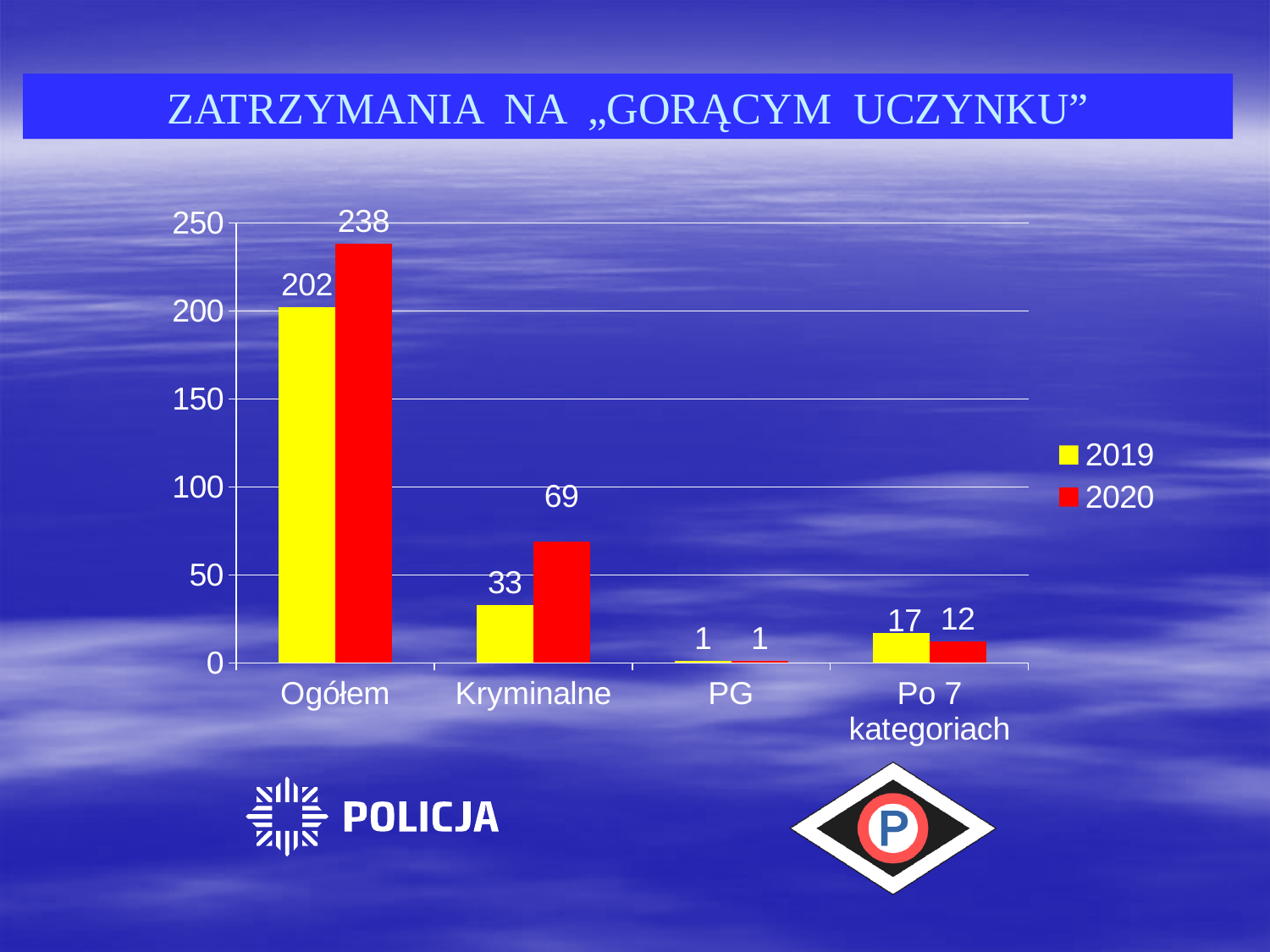
Which category has the highest value in 2020? Ogółem What is the value for Po 7 kategoriach in 2020? 12 Which is larger for Po 7 kategoriach, the 2019 value or the 2020 value? 2019 What is the value for Ogółem in 2020? 238 What is the difference between the 2020 and 2019 values for Ogółem? 36 What is the value for Kryminalne in 2019? 33 What is the difference between the 2020 and 2019 values for Kryminalne? 36 What kind of chart is shown on the slide? bar chart How many categories are shown on the x axis? 4 What is the value for PG in 2019? 1 Which category has the lowest value in 2019? PG How many series does the legend list? 2